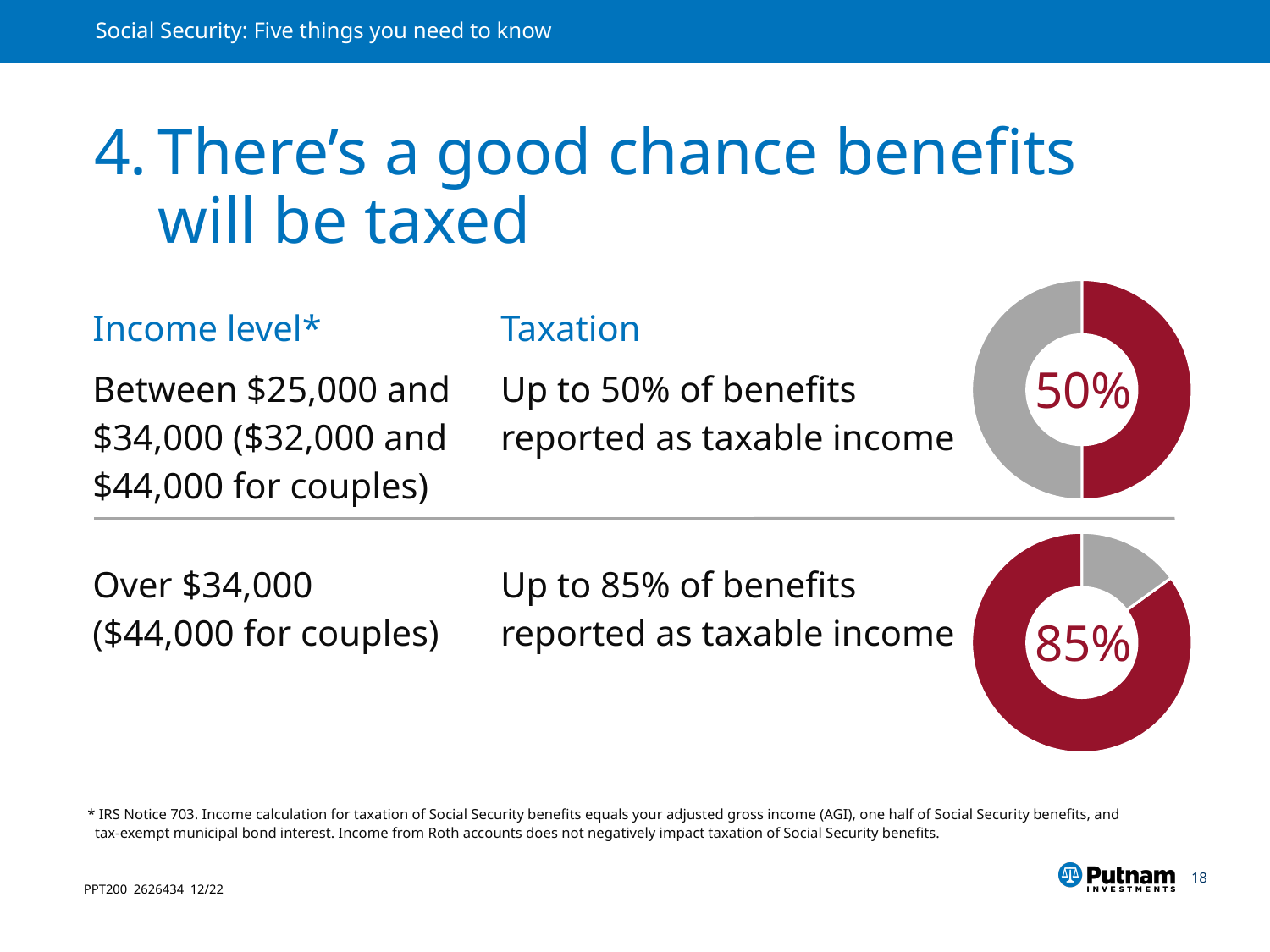
What kind of chart is shown on the right side of the slide next to each income level? Donut chart In the bottom donut chart, which colour covers the larger portion of the ring, red or gray? Red In the bottom donut chart, what percentage is printed in the centre? 85% What is the difference between the percentage shown in the bottom donut chart and the percentage shown in the top donut chart? 35% Which donut chart shows the smaller highlighted share, the top one or the bottom one? The top one What colour is used for the highlighted (taxable) portion in both donut charts? Red In the top donut chart, what percentage is printed in the centre? 50% How many donut charts are on the slide? 2 Is the highlighted share in the bottom donut chart greater or less than 50%? greater Which income level corresponds to the donut chart showing 85%? Over $34,000 ($44,000 for couples) In the top donut chart, is the red portion larger or smaller than the gray portion? Equal Which donut chart shows the larger highlighted share, the top one or the bottom one? The bottom one